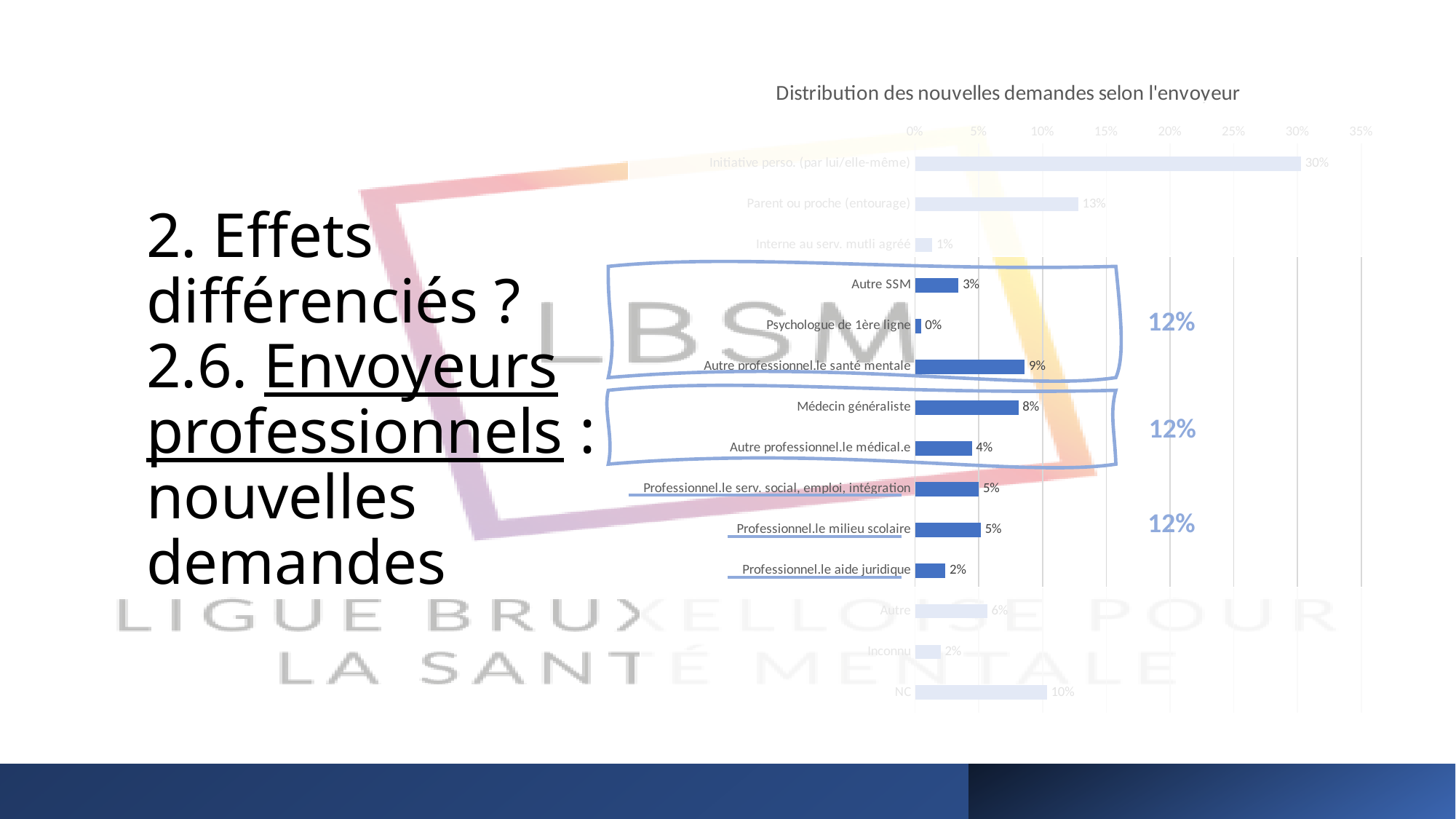
Which category has the lowest value? Psychologue de 1ère ligne What is the value for Médecin généraliste? 8% Which is larger, the value for Médecin généraliste or the value for Autre professionnel.le médical.e? Médecin généraliste What kind of chart is shown on the slide? bar chart Which category has the highest value? Initiative perso. (par lui/elle-même) What is the difference between the values for Initiative perso. (par lui/elle-même) and Parent ou proche (entourage)? 17% What is the value for Professionnel.le aide juridique? 2% What is the value for Autre professionnel.le santé mentale? 9% What is the title of the chart? Distribution des nouvelles demandes selon l'envoyeur How many categories are shown in the chart? 14 What is the combined value of Médecin généraliste and Autre professionnel.le médical.e? 12% What is the value for Initiative perso. (par lui/elle-même)? 30%